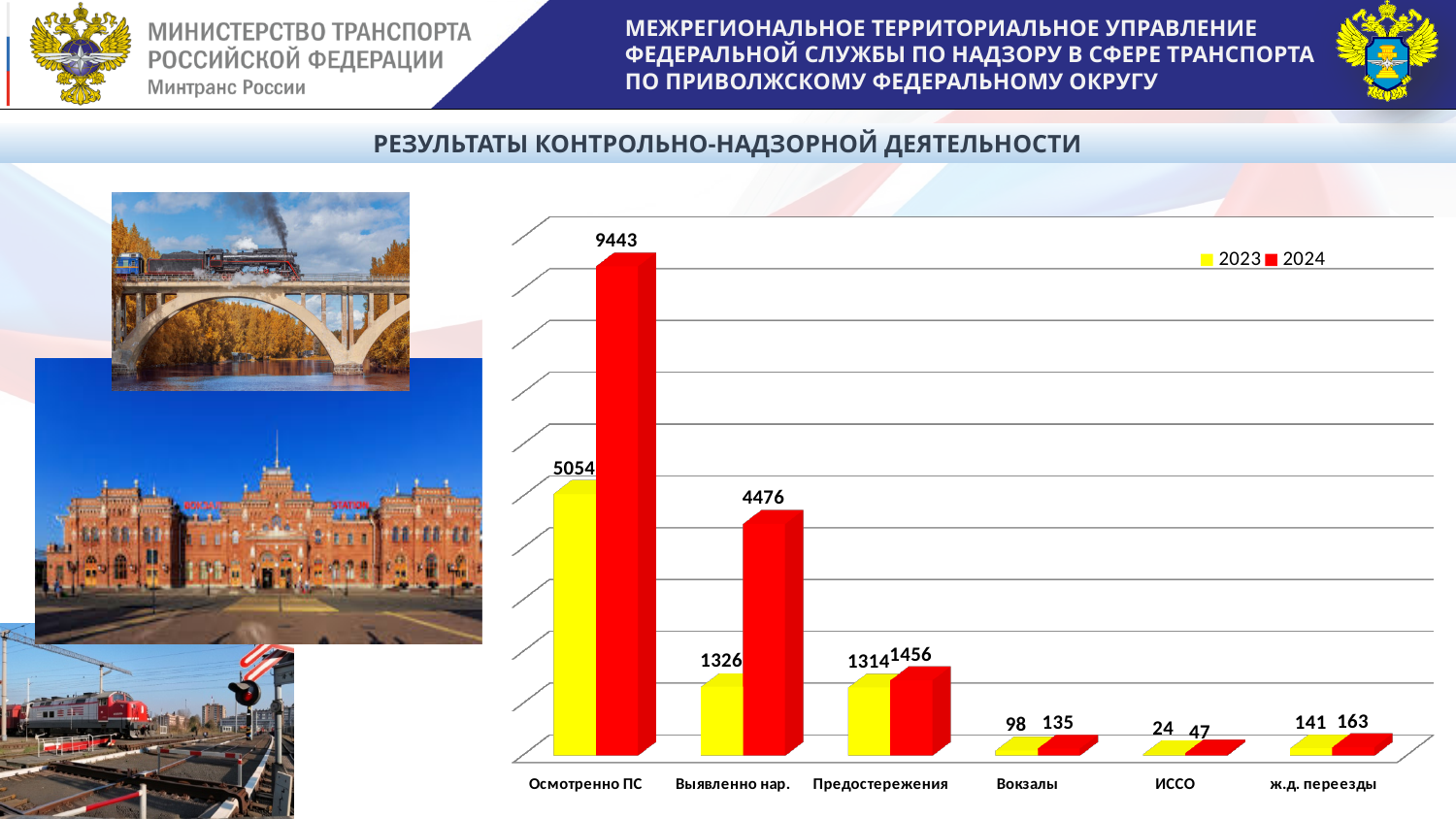
What is the 2023 value for Выявленно нар.? 1326 What is the 2024 value for ИССО? 47 Which category has the highest 2024 value? Осмотренно ПС Which is larger for Предостережения, the 2023 value or the 2024 value? 2024 How many series does the legend list? 2 What is the difference between the 2024 and 2023 values for Осмотренно ПС? 4389 Which category has the lowest 2023 value? ИССО How many categories are shown on the x axis? 6 What is the difference between the 2024 and 2023 values for Вокзалы? 37 What kind of chart is shown on the slide? bar chart What is the 2023 value for ж.д. переезды? 141 What is the 2024 value for Осмотренно ПС? 9443